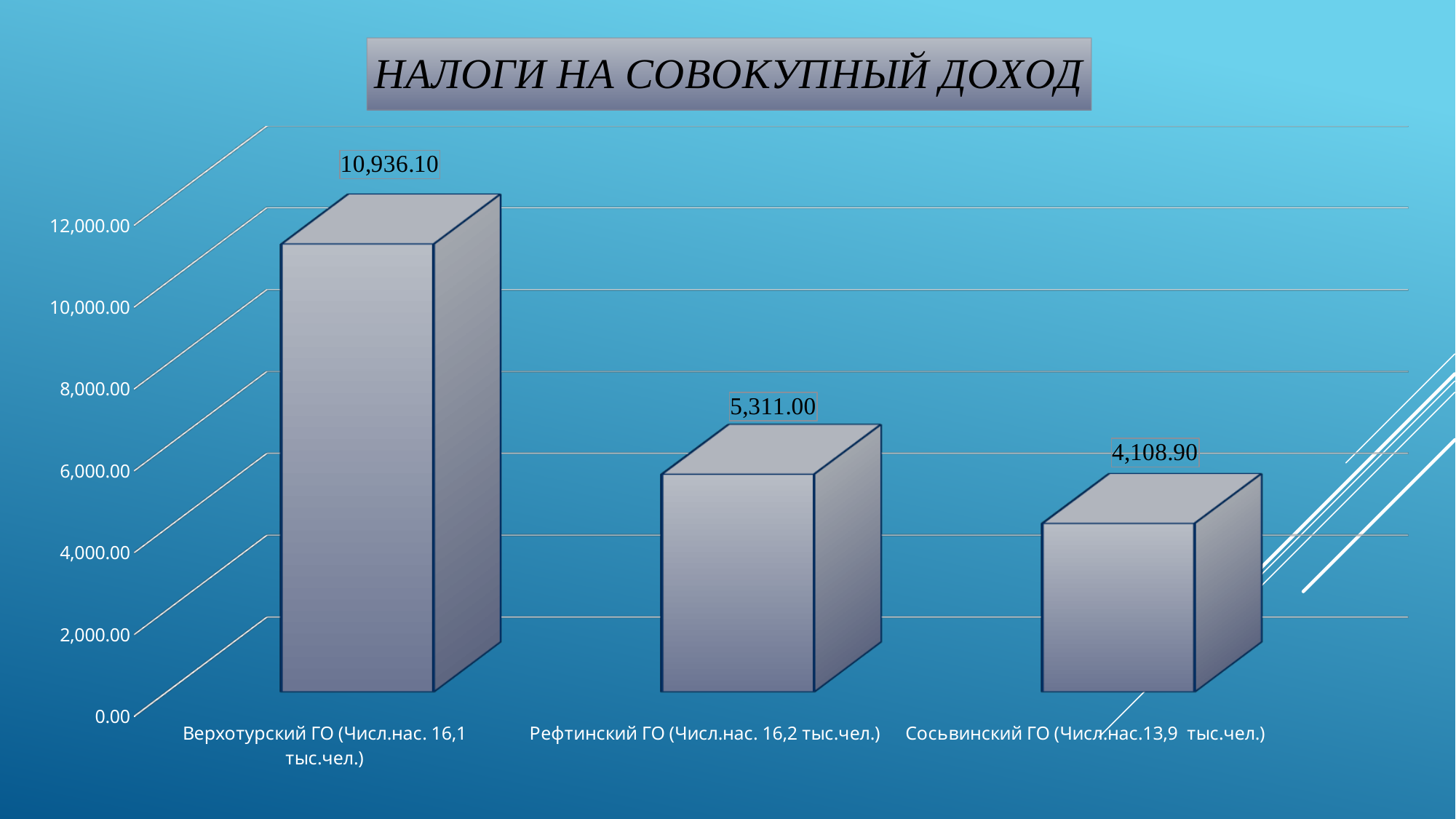
Which is larger, the value for Рефтинский ГО or the value for Сосьвинский ГО? Рефтинский ГО Which category has the highest value? Верхотурский ГО Is the value for Верхотурский ГО greater or less than 10,000.00? greater What kind of chart is shown on the slide? bar chart What is the value for Верхотурский ГО? 10,936.10 What is the title of the chart? НАЛОГИ НА СОВОКУПНЫЙ ДОХОД How many categories are shown in the chart? 3 Which category has the lowest value? Сосьвинский ГО What is the difference between the values for Рефтинский ГО and Сосьвинский ГО? 1,202.10 What is the difference between the values for Верхотурский ГО and Рефтинский ГО? 5,625.10 What is the value for Рефтинский ГО? 5,311.00 What is the value for Сосьвинский ГО? 4,108.90